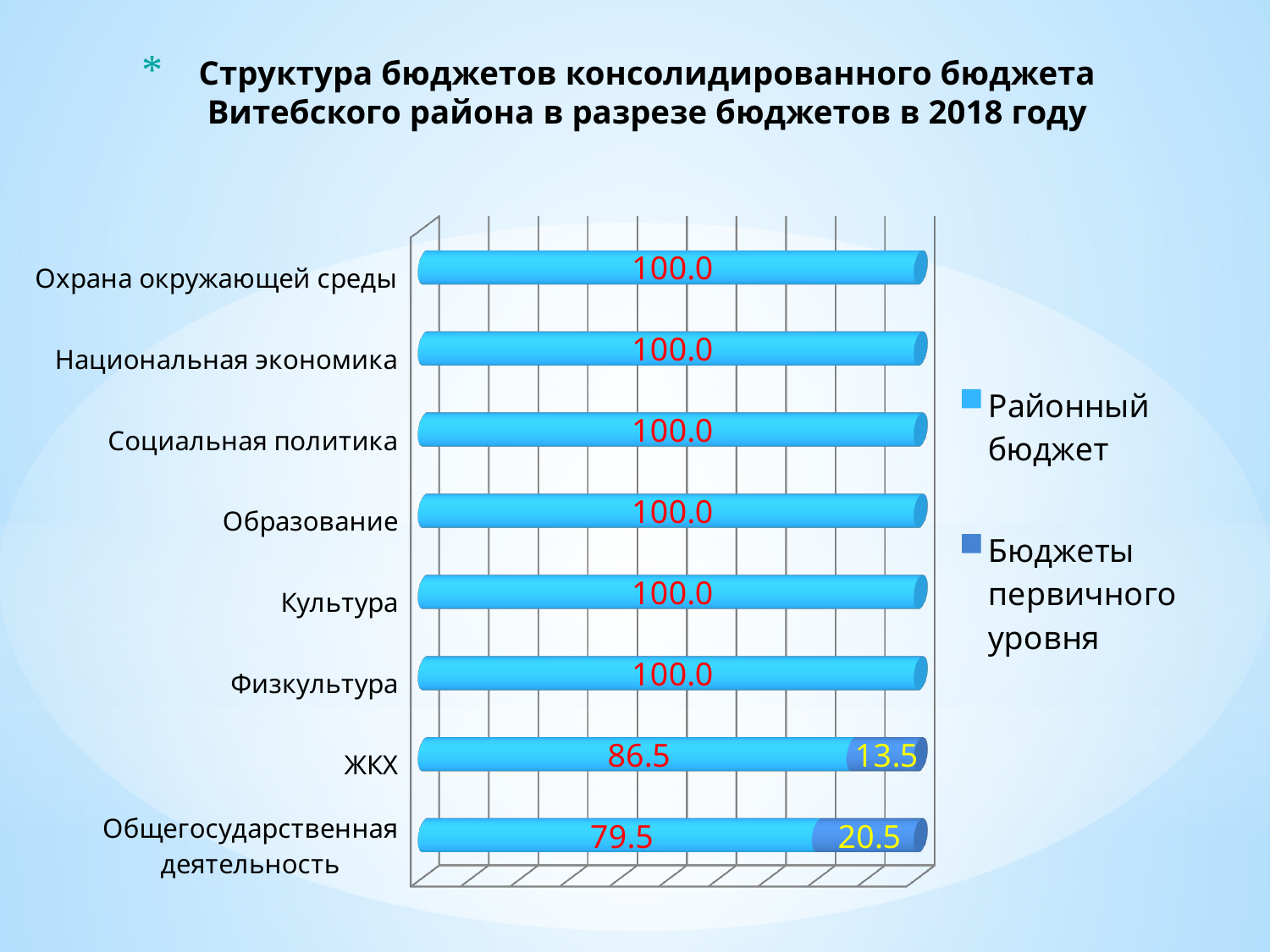
Which category has the lowest value for Районный бюджет? Общегосударственная деятельность What is the total of the stacked bar for ЖКХ? 100.0 How many categories are shown on the chart? 8 What is the value of Бюджеты первичного уровня for Общегосударственная деятельность? 20.5 What is the value of Бюджеты первичного уровня for ЖКХ? 13.5 What is the difference between the Районный бюджет values for ЖКХ and Общегосударственная деятельность? 7.0 Which is larger: the Бюджеты первичного уровня value for ЖКХ or for Общегосударственная деятельность? Общегосударственная деятельность Which category has the highest value for Бюджеты первичного уровня? Общегосударственная деятельность How many series does the legend list? 2 What is the value of Районный бюджет for ЖКХ? 86.5 What kind of chart is shown on the slide? Stacked bar chart What is the value of Районный бюджет for Образование? 100.0